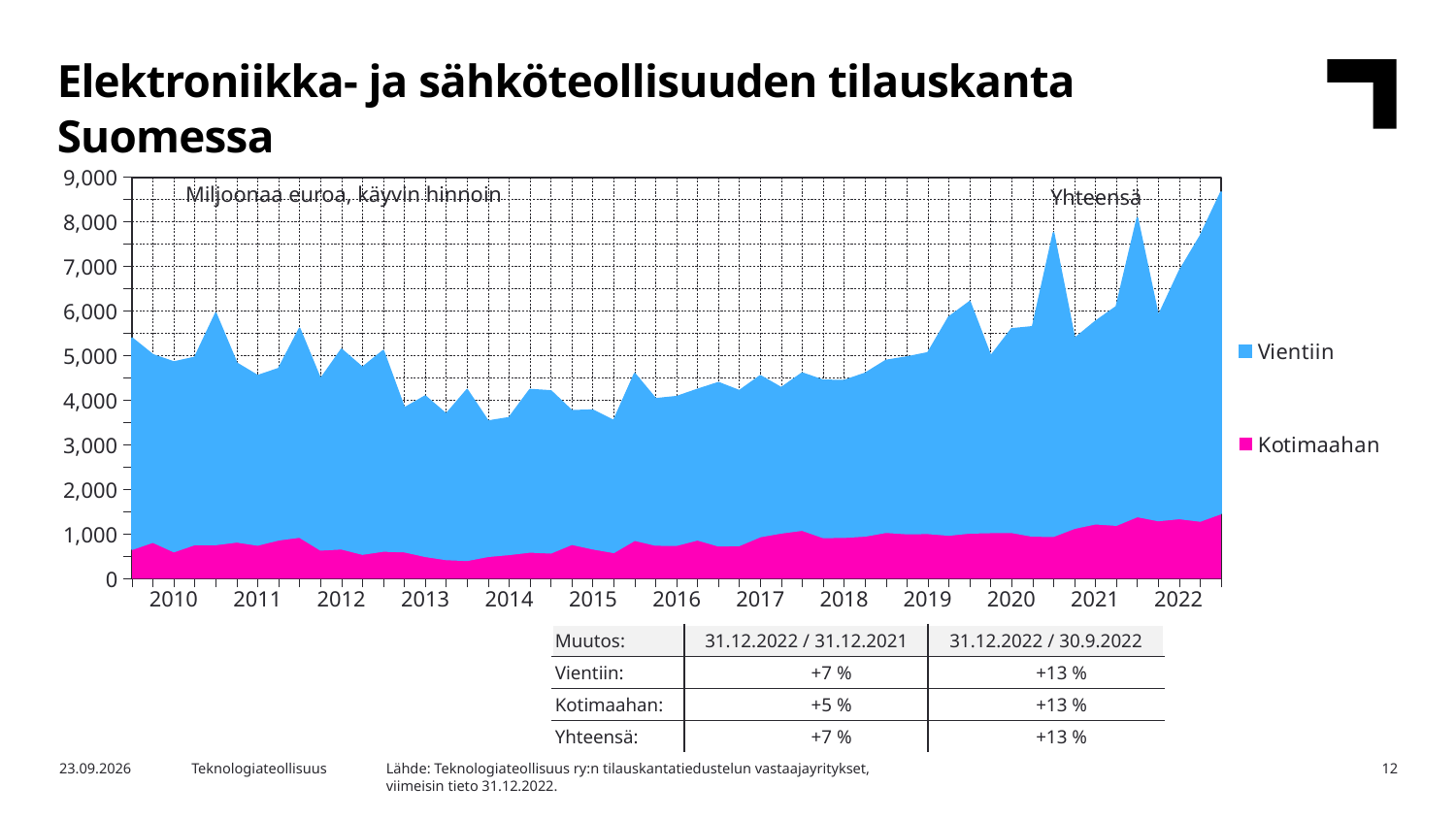
Is the total (Yhteensä) value at the end of 2022 greater or less than 8,000? greater Which two series are listed in the chart legend? Vientiin and Kotimaahan Which series is larger throughout the chart, Vientiin or Kotimaahan? Vientiin How many series does the chart legend list? 2 What unit is stated in the label at the top left of the chart area? Miljoonaa euroa, käyvin hinnoin Does the total (Yhteensä) value generally rise or fall from 2018 to 2022? rise Is the Kotimaahan value in 2014 greater or less than 1,000? less What is the highest value shown on the y axis of the chart? 9,000 Is the Kotimaahan value at the end of 2022 greater or less than 1,000? greater How many year labels are shown on the x axis? 13 What kind of chart is shown on the slide? Stacked area chart